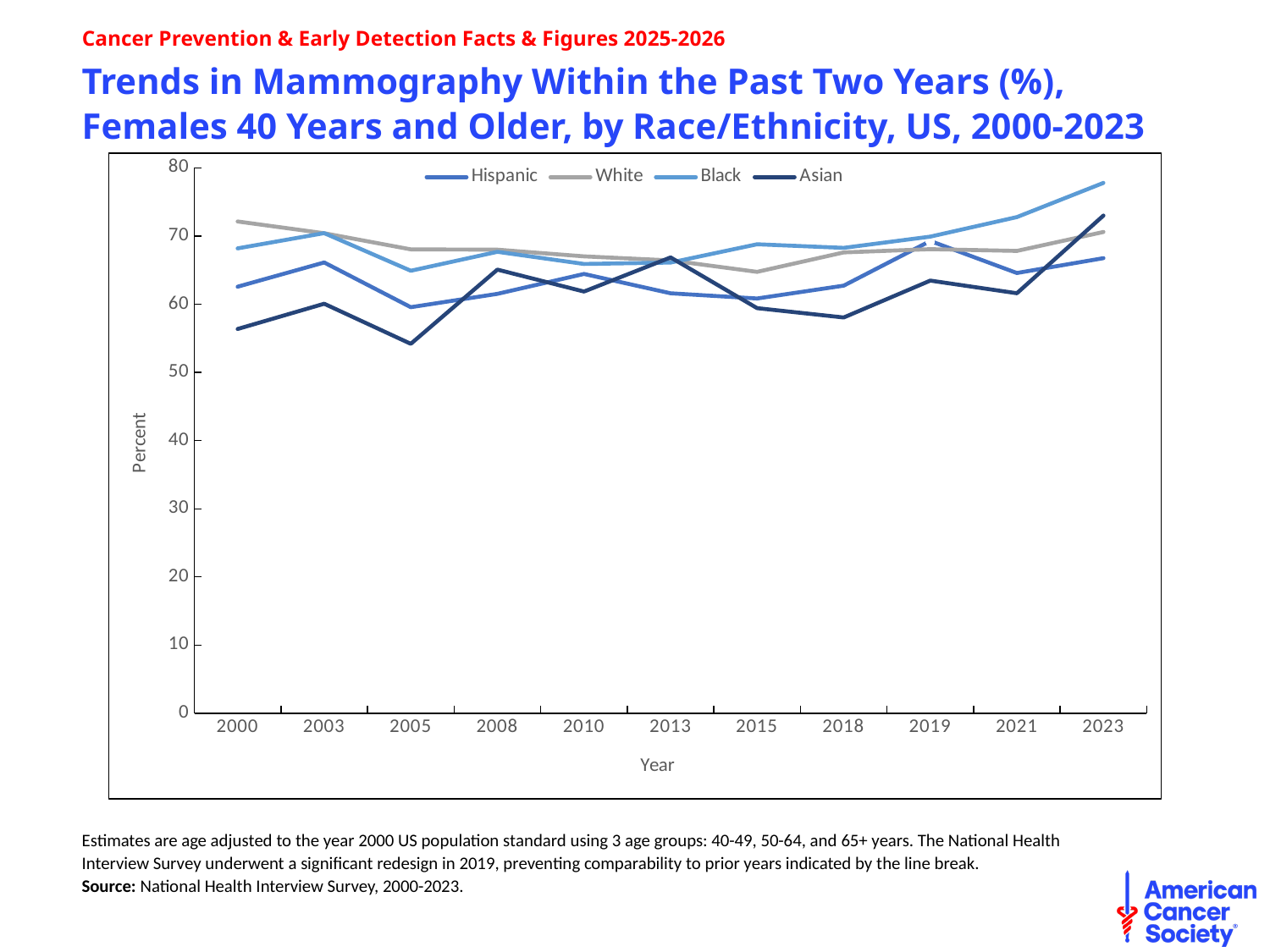
In 2023, which is larger, the value for Black or the value for Hispanic? Black Is the value for Black in 2023 greater or less than 70? greater What kind of chart is shown on the slide? line chart Which race/ethnicity group has the highest value in 2000? White Is the value for White in 2000 greater or less than 70? greater What is the label on the y axis? Percent Which race/ethnicity group has the lowest value in 2005? Asian Does the Black line rise or fall from 2015 to 2023? rise Which race/ethnicity group has the highest value in 2023? Black How many series does the legend list? 4 Is the value for Asian in 2005 greater or less than 60? less How many years are marked on the x axis? 11